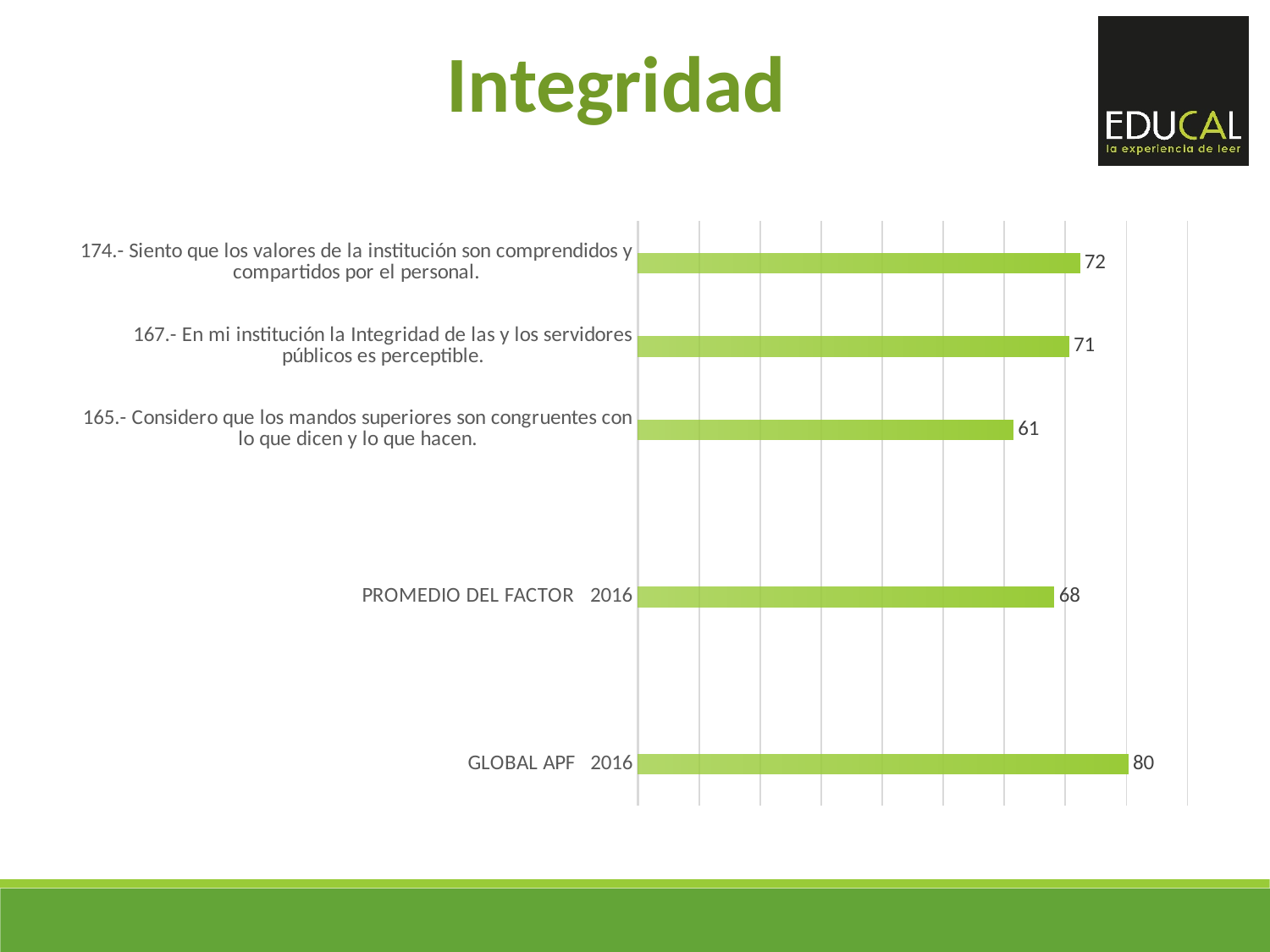
Which is larger, the value for item 167 or the value for PROMEDIO DEL FACTOR 2016? Item 167 What is the value for PROMEDIO DEL FACTOR 2016? 68 Which category has the highest value? GLOBAL APF 2016 What is the title of the slide containing the chart? Integridad What is the value for GLOBAL APF 2016? 80 What is the value for item 174 (Siento que los valores de la institución son comprendidos y compartidos por el personal)? 72 What is the difference between the values for item 174 and item 165? 11 Which category has the lowest value? 165.- Considero que los mandos superiores son congruentes con lo que dicen y lo que hacen. How many bars are plotted in the chart? 5 What kind of chart is shown on the slide? Bar chart What is the value for item 165 (Considero que los mandos superiores son congruentes con lo que dicen y lo que hacen)? 61 What is the difference between the value for GLOBAL APF 2016 and PROMEDIO DEL FACTOR 2016? 12